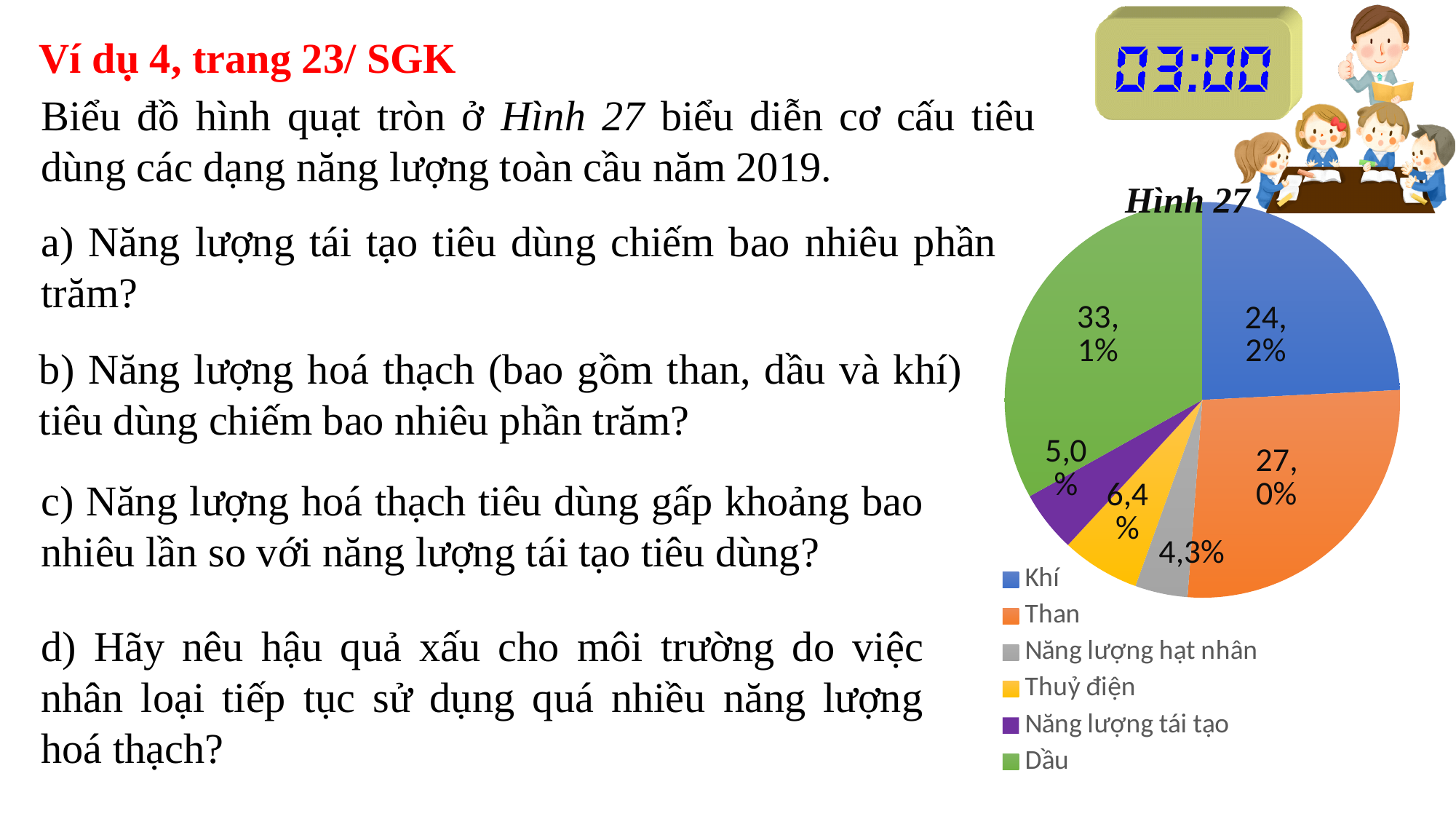
What is the difference between the Dầu slice and the Than slice? 6,1% Which is larger, the Than slice or the Khí slice? Than What percentage does the Năng lượng tái tạo slice represent? 5,0% What percentage does the Than slice represent? 27,0% What percentage does the Khí slice represent? 24,2% What kind of chart is shown on the slide? pie chart How many categories does the legend list? 6 Which category has the smallest slice of the pie? Năng lượng hạt nhân What percentage does the Dầu slice represent? 33,1% Which category has the largest slice of the pie? Dầu What colour is the Thuỷ điện slice? yellow What percentage does the Thuỷ điện slice represent? 6,4%